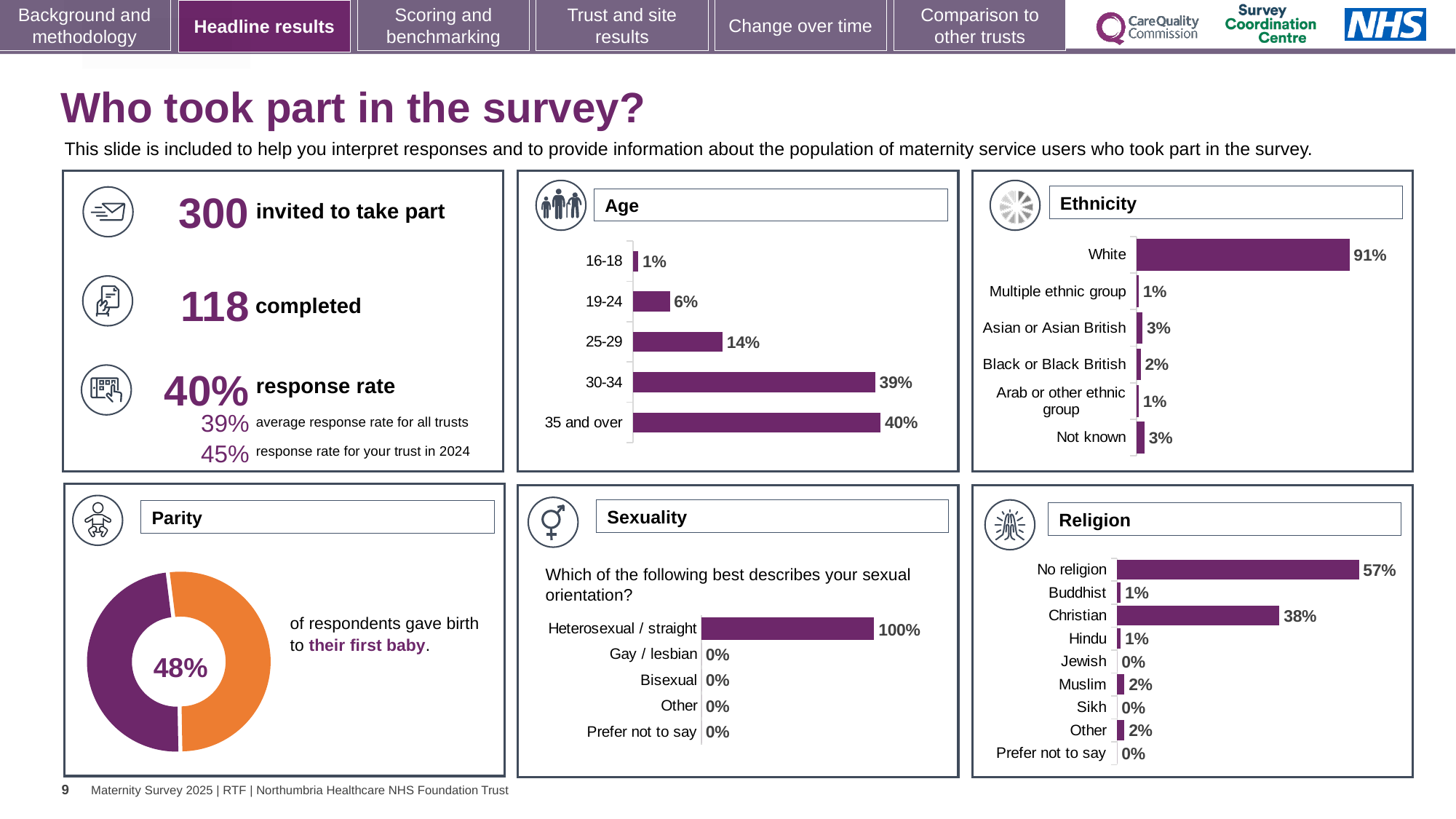
In the Ethnicity chart, what percentage of respondents were White? 91% In the Religion chart, what percentage of respondents were Christian? 38% In the Religion chart, which category has the highest percentage? No religion In the Age chart, what percentage of respondents were aged 30-34? 39% In the Ethnicity chart, which is larger: Asian or Asian British or Black or Black British? Asian or Asian British In the Religion chart, what is the difference between No religion and Christian? 19% How many age groups are shown in the Age chart? 5 In the Age chart, which age group has the highest percentage? 35 and over What kind of chart is the Parity chart? Doughnut chart In the Age chart, what is the difference between the 35 and over group and the 25-29 group? 26% In the Ethnicity chart, how many ethnicity categories are listed? 6 In the Sexuality chart, what percentage of respondents answered Heterosexual / straight? 100%